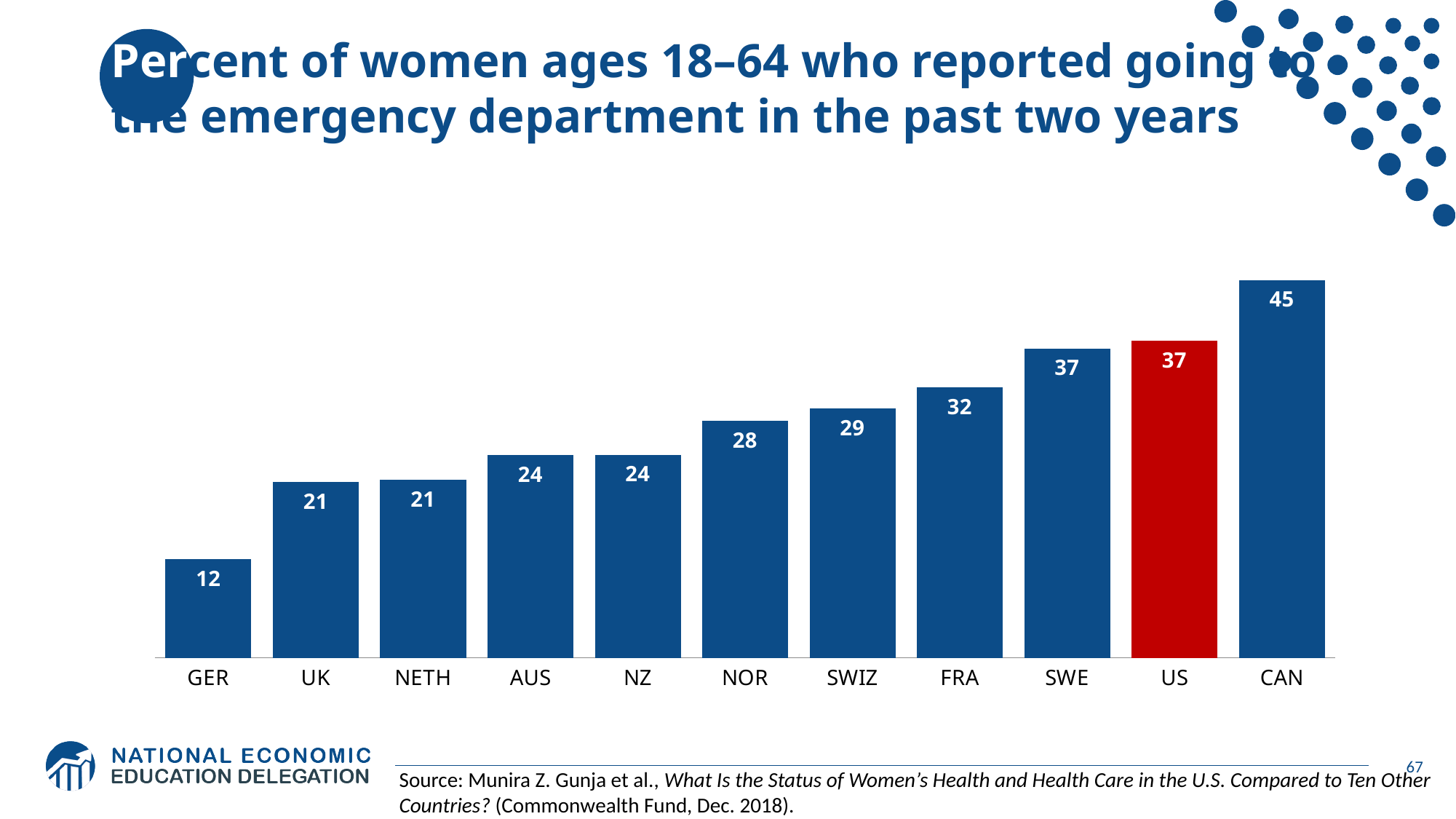
How many countries are shown in the chart? 11 What is the difference between the values for CAN and the US? 8 What kind of chart is shown on the slide? bar chart Which is larger, the value for SWIZ or the value for AUS? SWIZ What is the value for the US? 37 Do the values rise or fall from left to right along the x axis? rise What is the difference between the values for NOR and GER? 16 What is the value for GER? 12 What is the value for FRA? 32 Which country has the highest value? CAN Which country's bar is coloured red? US Which country has the lowest value? GER